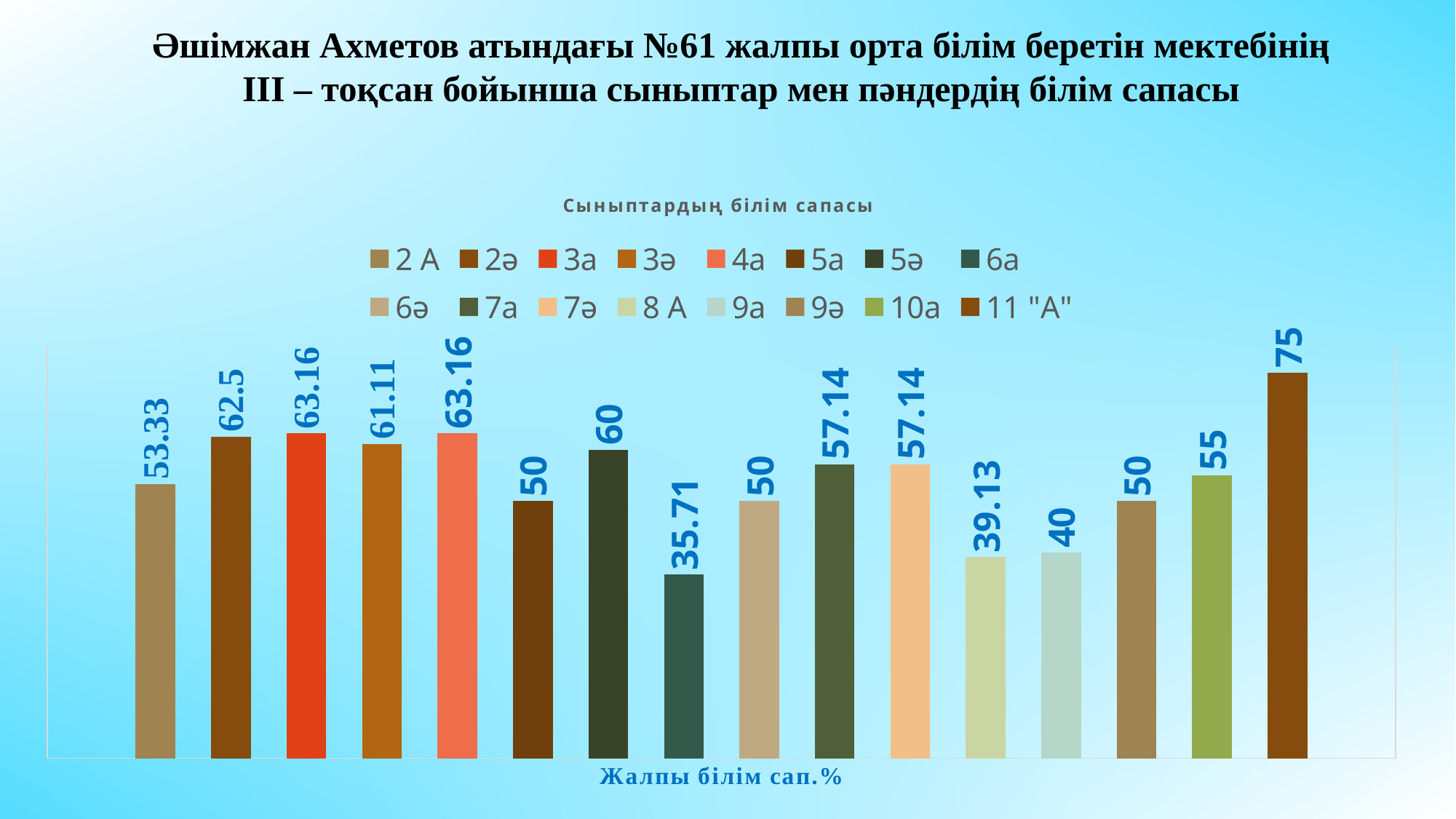
What is the difference between the values for 11 "А" and 6а? 39.29 What is the difference between the values for 10а and 9а? 15 What is the value for 2 А? 53.33 What is the title of the chart? Сыныптардың білім сапасы What is the value for 8 А? 39.13 What type of chart is shown on the slide? bar chart Which is larger, the value for 2ә or the value for 3ә? 2ә What is the value for 6а? 35.71 What is the value for 11 "А"? 75 How many series does the legend list? 16 Which class has the lowest value? 6а Which class has the highest value? 11 "А"